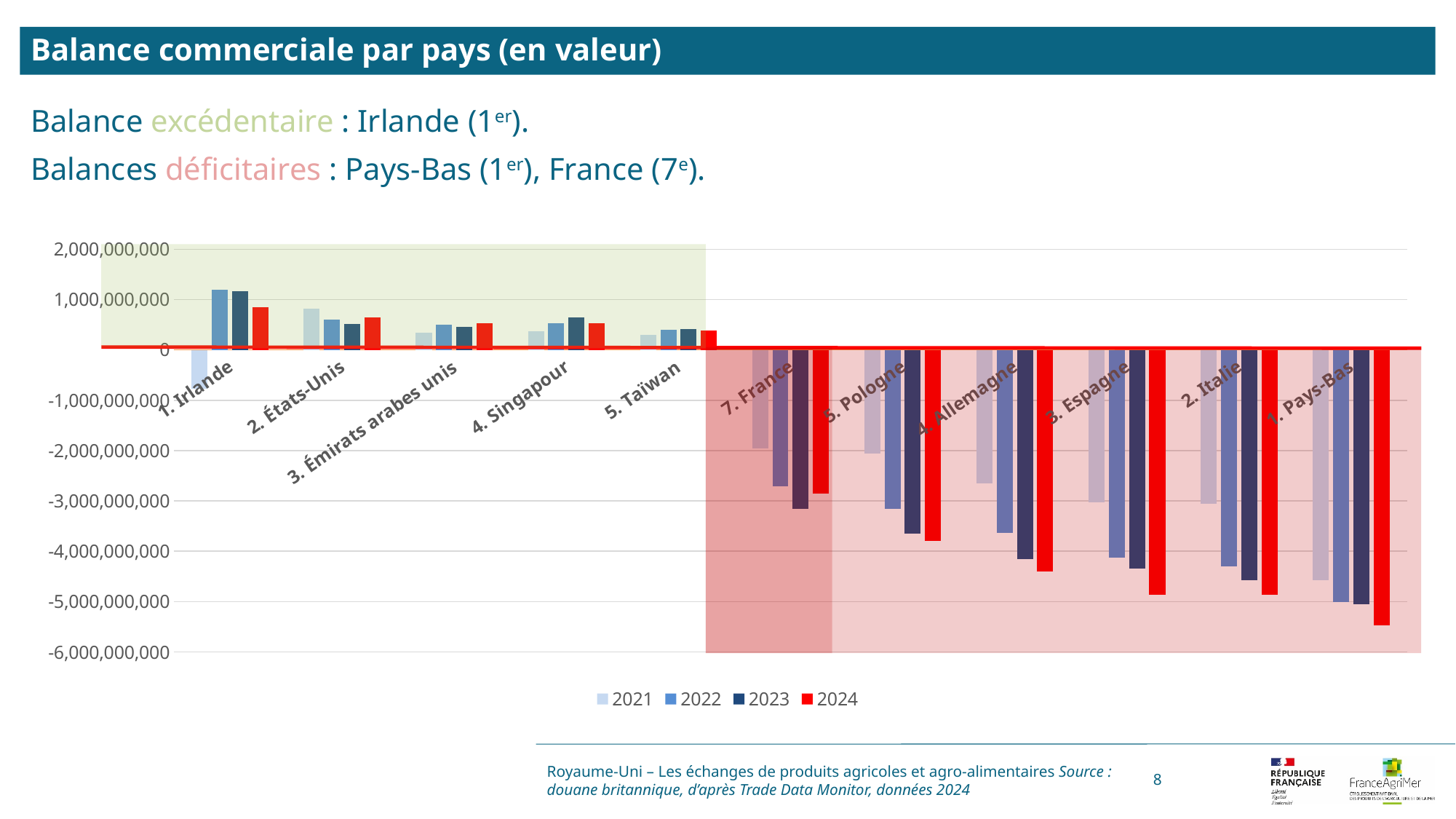
Is the 2024 value for 1. Pays-Bas greater or less than -5,000,000,000? less How many countries are shown on the x axis of the chart? 11 For 1. Pays-Bas, do the values rise or fall from 2021 to 2024? fall Which country has the highest value for 2024? 1. Irlande Is the 2024 value for 4. Allemagne greater or less than -5,000,000,000? greater What colour represents the 2024 series in the legend? red What kind of chart is shown on the slide? bar chart Is the 2022 value for 1. Irlande greater or less than 1,000,000,000? greater Which country has the lowest (most negative) value for 2024? 1. Pays-Bas How many series does the legend list? 4 For 1. Irlande, which is larger: the 2022 value or the 2024 value? 2022